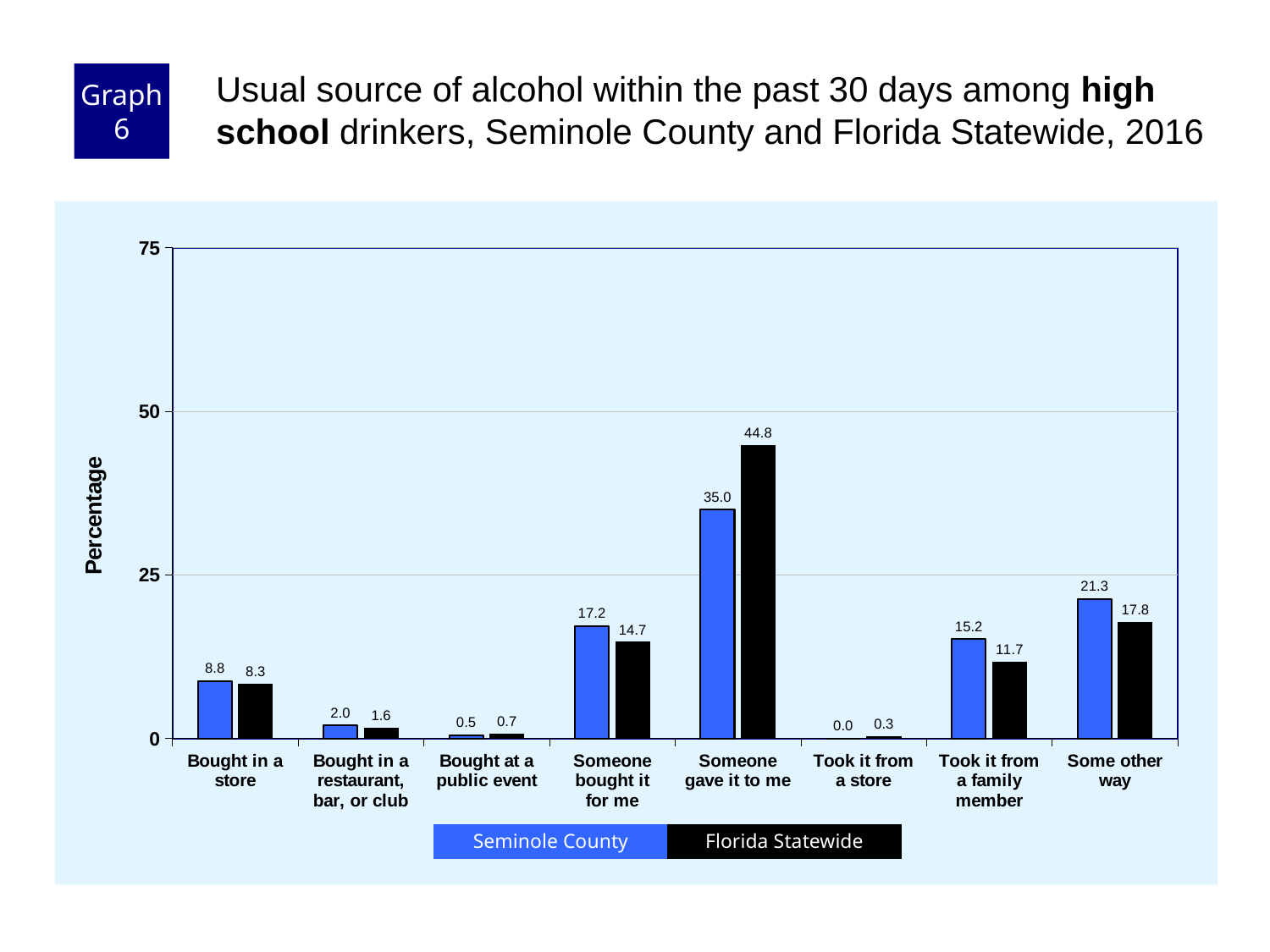
What is the Florida Statewide value for "Took it from a family member"? 11.7 Which category has the highest Florida Statewide value? Someone gave it to me What is the Seminole County value for "Someone gave it to me"? 35.0 What is the difference between the Seminole County and Florida Statewide values for "Some other way"? 3.5 What is the difference between the Florida Statewide and Seminole County values for "Someone gave it to me"? 9.8 Is the Florida Statewide value for "Someone gave it to me" greater or less than 50? less How many series does the legend list? 2 Which category has the lowest Seminole County value? Took it from a store What is the Seminole County value for "Bought at a public event"? 0.5 Which is larger for "Someone bought it for me": Seminole County or Florida Statewide? Seminole County How many categories are shown on the x axis? 8 What kind of chart is shown on the slide? bar chart